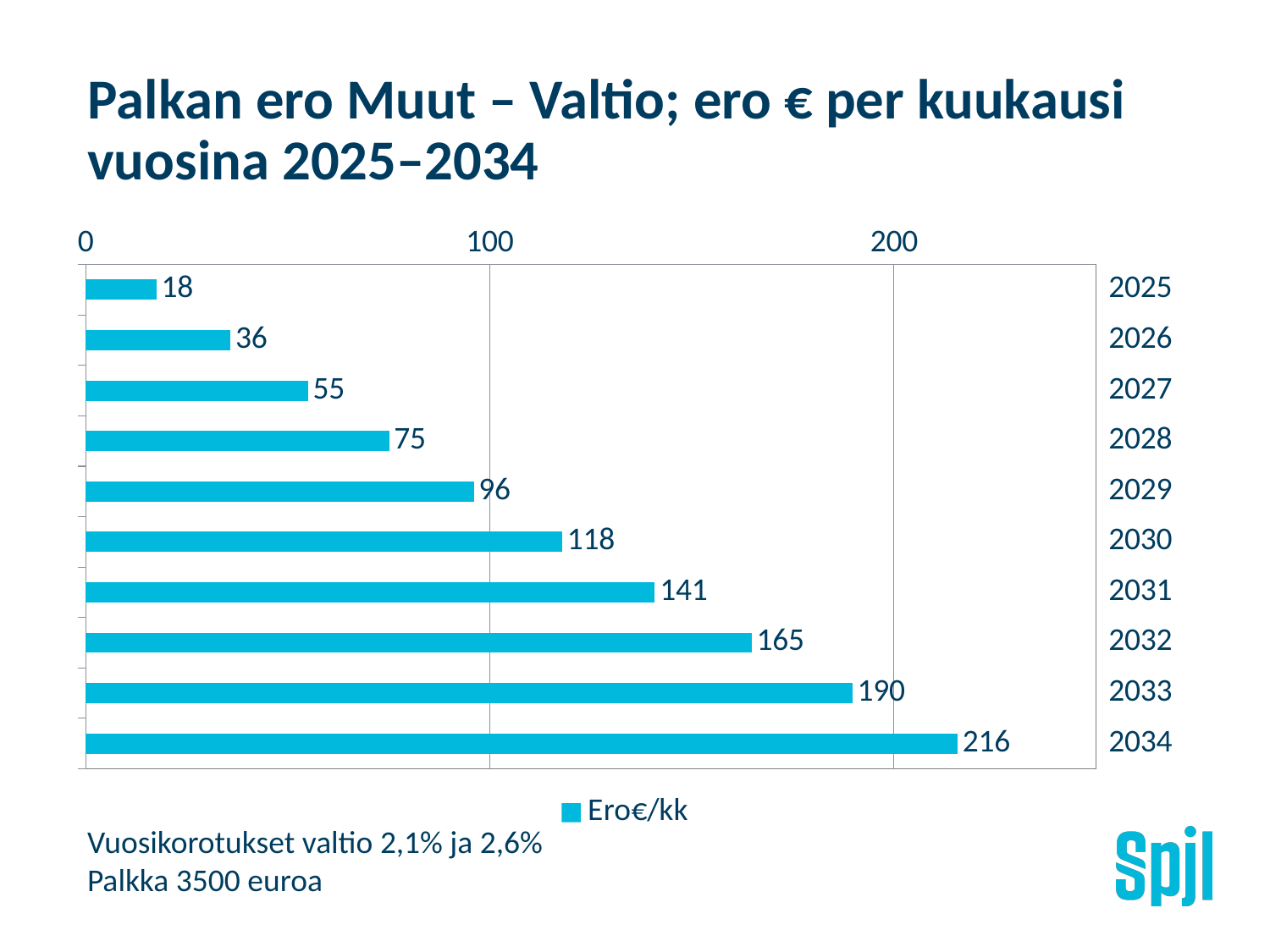
Do the values rise or fall from 2025 to 2034? Rise What is the value for 2029? 96 Is the value for 2033 greater or less than 100? greater What kind of chart is shown on the slide? Bar chart What is the difference between the values for 2030 and 2025? 100 Which year has the lowest value? 2025 Which year has the highest value? 2034 What is the value for 2032? 165 How many series does the legend list? 1 How many years are shown in the chart? 10 What is the difference between the values for 2034 and 2033? 26 Which is larger, the value for 2028 or the value for 2031? 2031